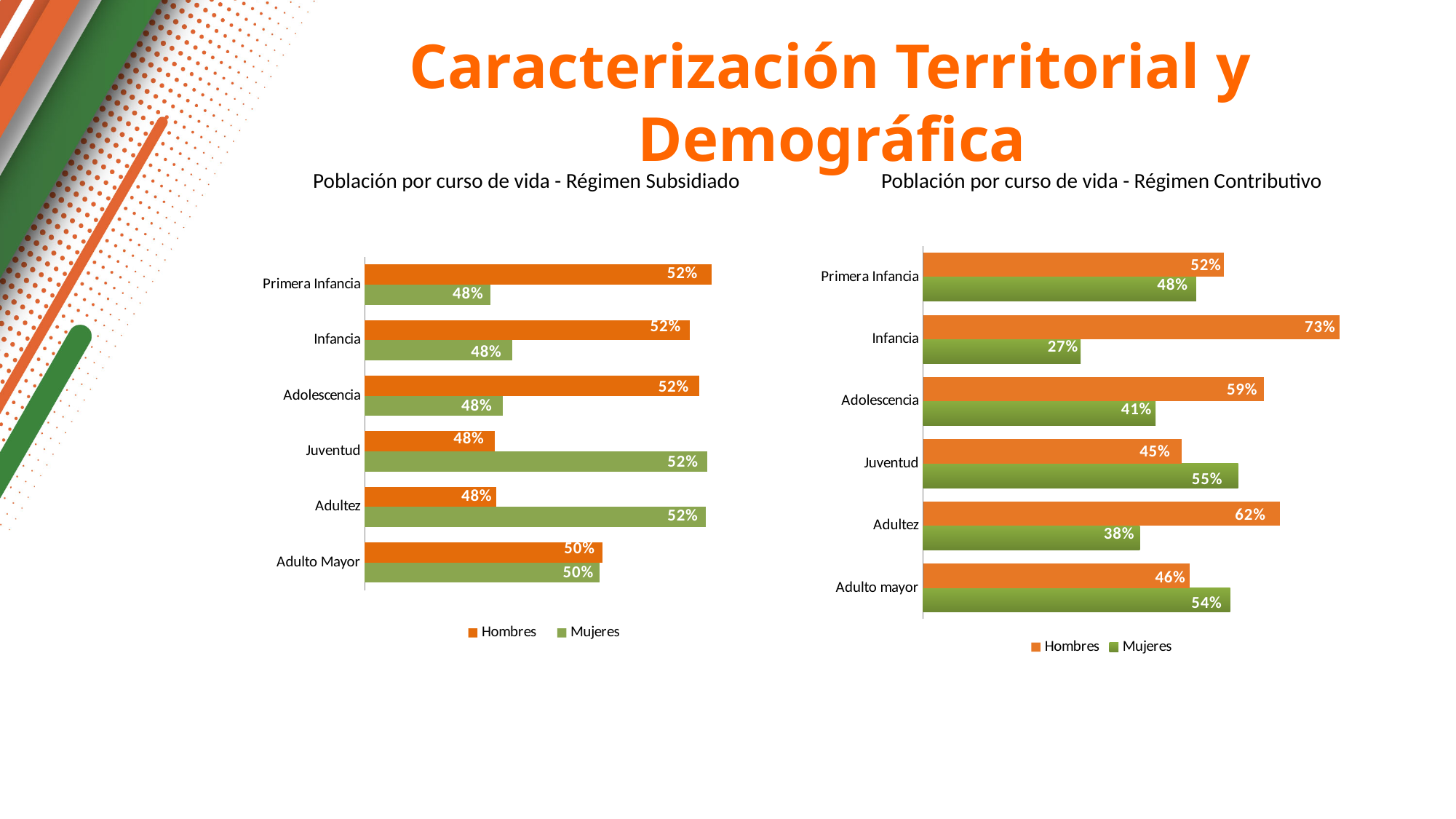
In the 'Población por curso de vida - Régimen Subsidiado' chart, what is the value for Mujeres in Juventud? 52% How many categories does the 'Población por curso de vida - Régimen Subsidiado' chart show? 6 In the 'Población por curso de vida - Régimen Subsidiado' chart, what is the value for Hombres in Adulto Mayor? 50% In the 'Población por curso de vida - Régimen Contributivo' chart, which category has the highest Hombres value? Infancia In the 'Población por curso de vida - Régimen Contributivo' chart, what is the value for Hombres in Infancia? 73% What kind of chart is 'Población por curso de vida - Régimen Subsidiado'? Bar chart In the 'Población por curso de vida - Régimen Contributivo' chart, which is larger in Juventud, Hombres or Mujeres? Mujeres In the 'Población por curso de vida - Régimen Contributivo' chart, what is the value for Mujeres in Adultez? 38% In the 'Población por curso de vida - Régimen Contributivo' chart, which category has the lowest Mujeres value? Infancia In the 'Población por curso de vida - Régimen Subsidiado' chart, what is the value for Hombres in Primera Infancia? 52% How many series does the legend of the 'Población por curso de vida - Régimen Contributivo' chart list? 2 In the 'Población por curso de vida - Régimen Contributivo' chart, what is the difference between Hombres and Mujeres in Adolescencia? 18%